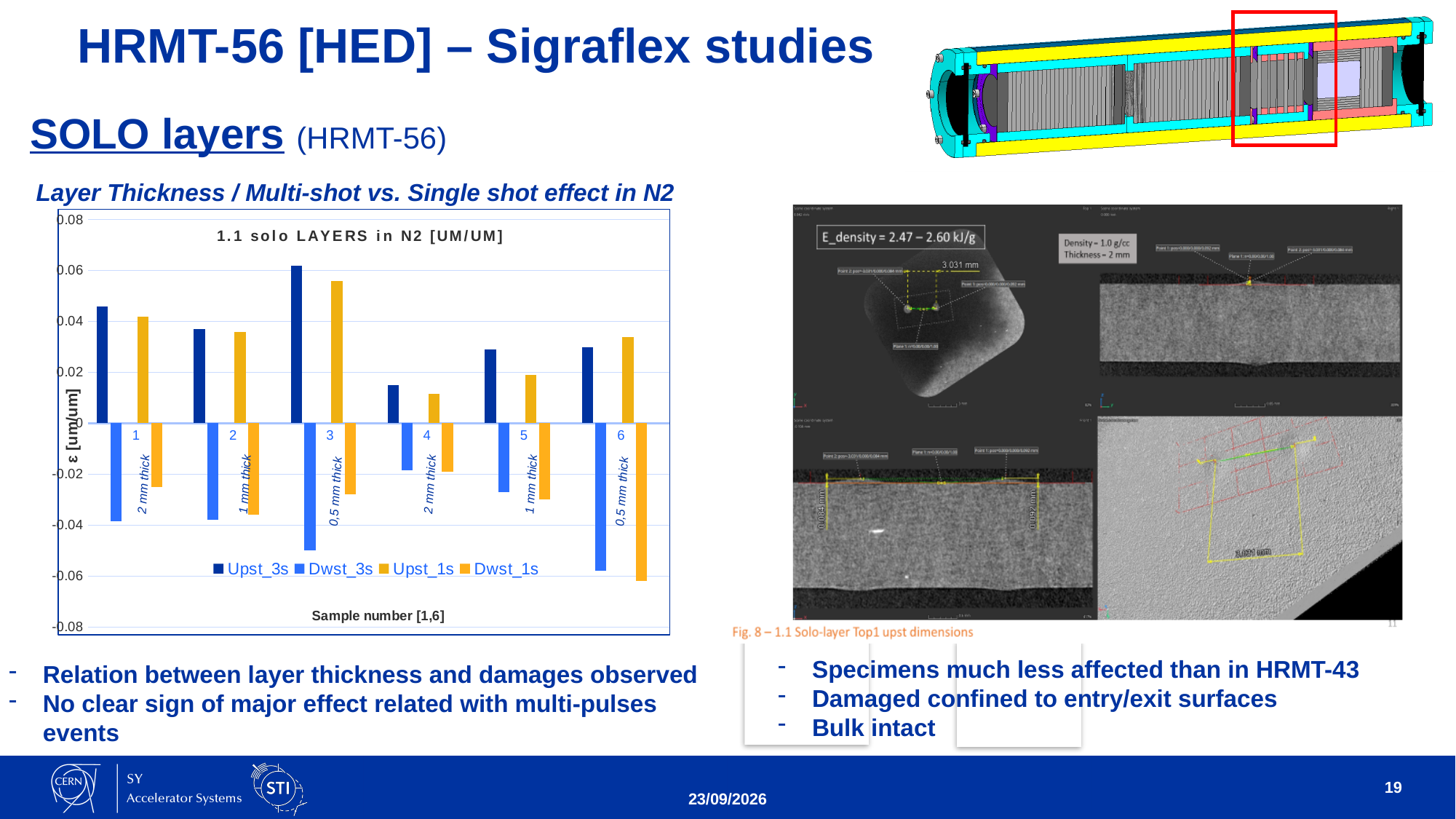
How many sample numbers are shown on the x axis of the chart? 6 Which is larger for sample 3, the Upst_3s value or the Upst_1s value? Upst_3s Is the Upst_3s value for sample 3 greater or less than 0.06? greater Which is larger for sample 5, the Upst_3s value or the Upst_1s value? Upst_3s What is the label of the x axis of the chart? Sample number [1,6] What is the title of the chart? 1.1 solo LAYERS in N2 [UM/UM] Which sample number has the lowest Upst_3s value? 4 What kind of chart is shown on the slide? bar chart Which sample number has the highest Upst_3s value? 3 Is the Upst_1s value for sample 4 greater or less than 0.02? less Is the Dwst_1s value for sample 6 greater or less than -0.06? less How many series does the legend of the chart list? 4